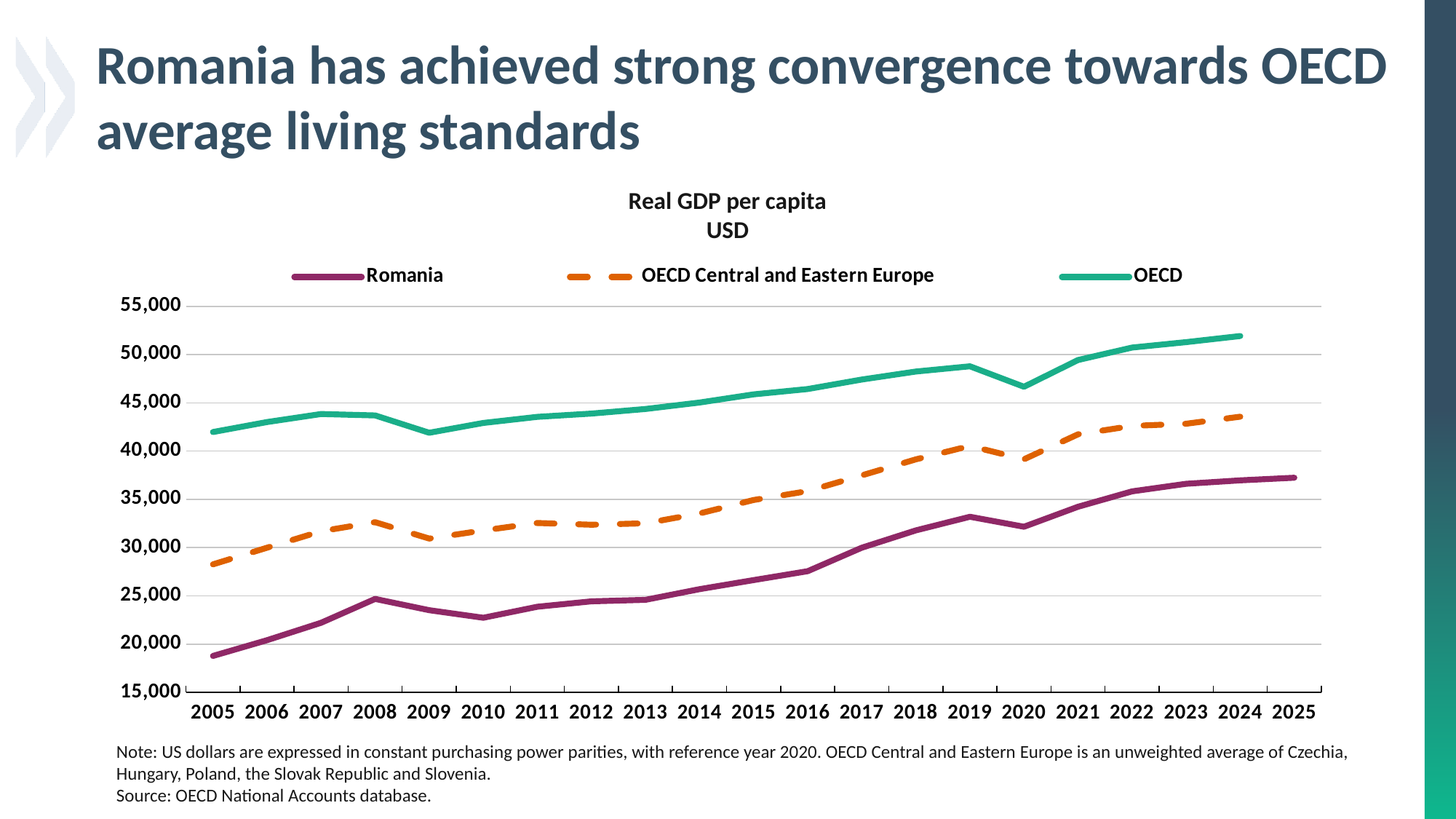
What kind of chart is shown on the slide? line chart Which series has the highest value in 2024? OECD How many series does the legend list? 3 Is the value for OECD in 2024 greater or less than 50,000? greater Is the value for OECD Central and Eastern Europe in 2024 greater or less than 45,000? less Which series is drawn with a dashed orange line? OECD Central and Eastern Europe Is the value for Romania in 2024 greater or less than 35,000? greater Which series has the lowest value in 2005? Romania Does the Romania series rise or fall overall from 2005 to 2024? rise What is the title of the chart? Real GDP per capita USD